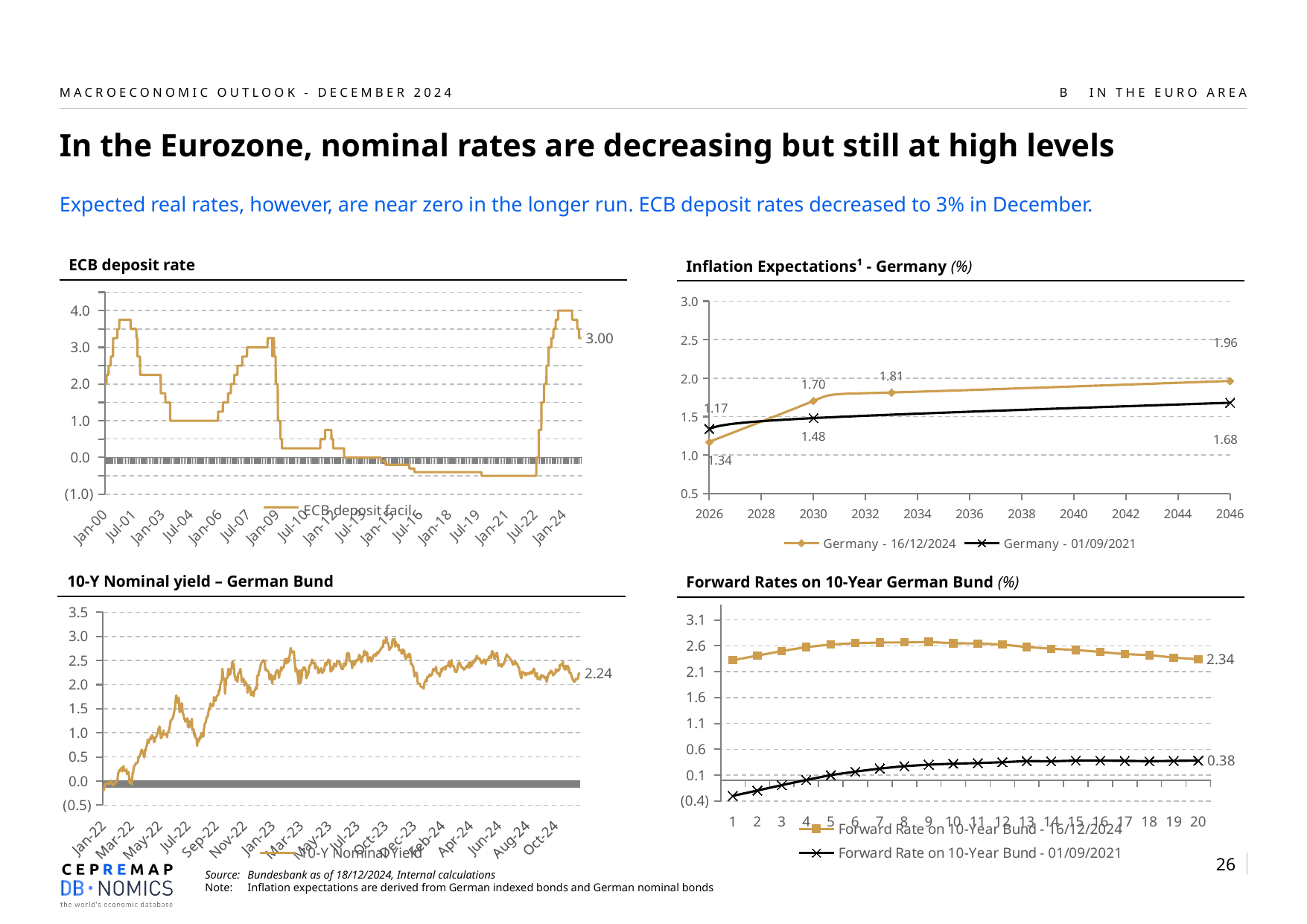
In the Forward Rates on 10-Year German Bund chart, what is the value labelled at the end of the 16/12/2024 series? 2.34 In the ECB deposit rate chart, is the peak value reached in 2023–2024 greater or less than 3.0? greater In the Inflation Expectations - Germany chart, what is the difference between the 2030 values of the 16/12/2024 and 01/09/2021 series? 0.22 In the Forward Rates on 10-Year German Bund chart, what is the difference between the final labelled values of the 16/12/2024 and 01/09/2021 series? 1.96 In the Inflation Expectations - Germany chart, what is the value for Germany - 01/09/2021 in 2026? 1.34 In the 10-Y Nominal yield – German Bund chart, what is the latest value labelled at the end of the line? 2.24 In the ECB deposit rate chart, what is the latest value labelled at the end of the line? 3.00 How many series does the legend of the Inflation Expectations - Germany chart list? 2 In the Inflation Expectations - Germany chart, what is the value for Germany - 16/12/2024 in 2046? 1.96 How many points are shown on the x axis of the Forward Rates on 10-Year German Bund chart? 20 In the Inflation Expectations - Germany chart, what is the difference between the 2046 values of the 16/12/2024 and 01/09/2021 series? 0.28 In the Inflation Expectations - Germany chart, which series has the higher value in 2026? Germany - 01/09/2021